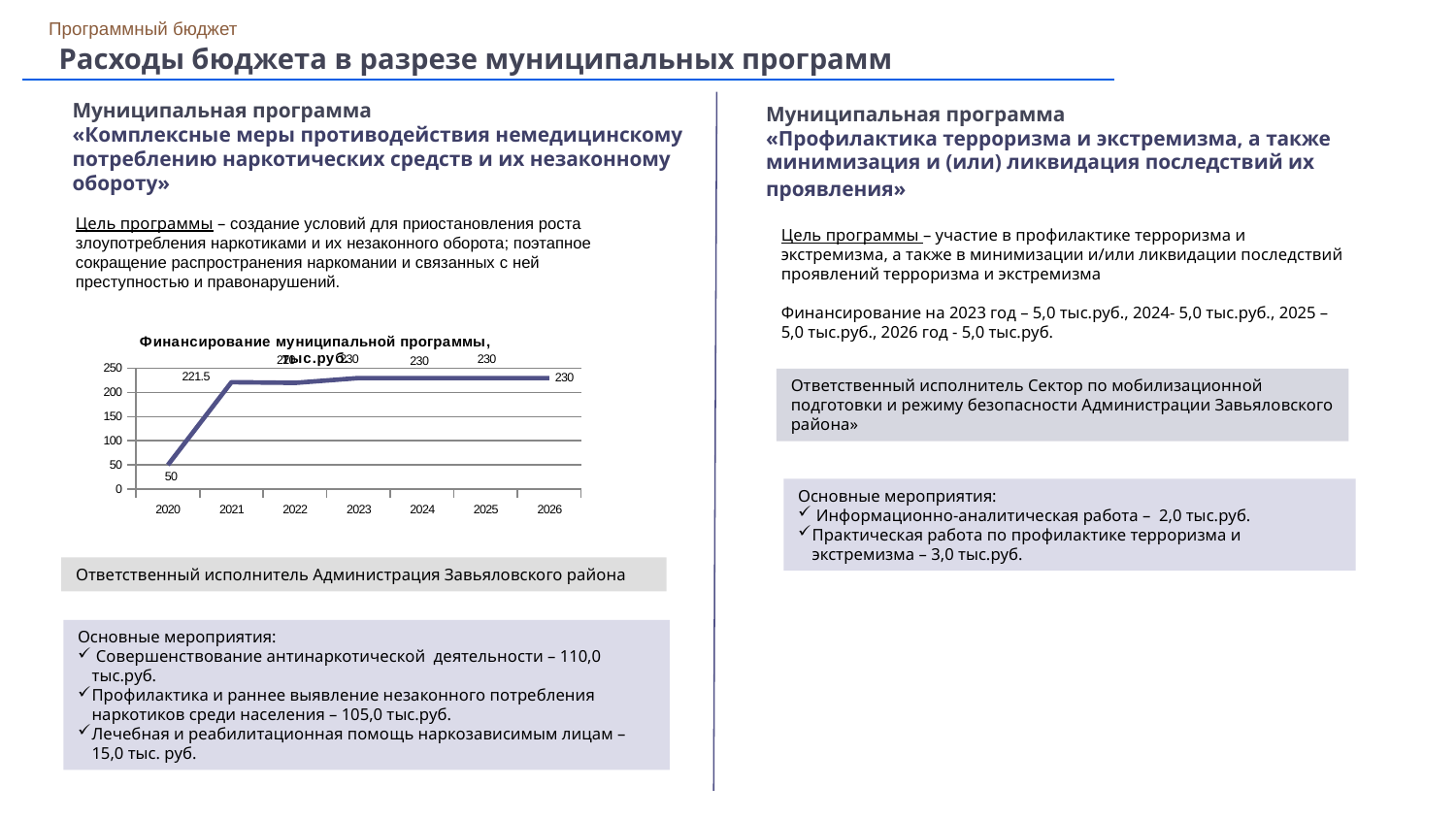
Which is larger, the value for 2021 or the value for 2020? 2021 Which year has the lowest value in the chart? 2020 Does the value rise or fall from 2020 to 2021? rise What is the value for 2023 in the chart? 230 Is the value for 2022 greater or less than 200? greater What kind of chart is shown on the slide? line chart What is the value for 2021 in the chart? 221.5 What is the title of the chart on the slide? Финансирование муниципальной программы, тыс.руб. What is the value for 2026 in the chart? 230 What is the value for 2020 in the chart? 50 How many years are shown on the x axis of the chart? 7 What is the difference between the values for 2021 and 2020? 171.5